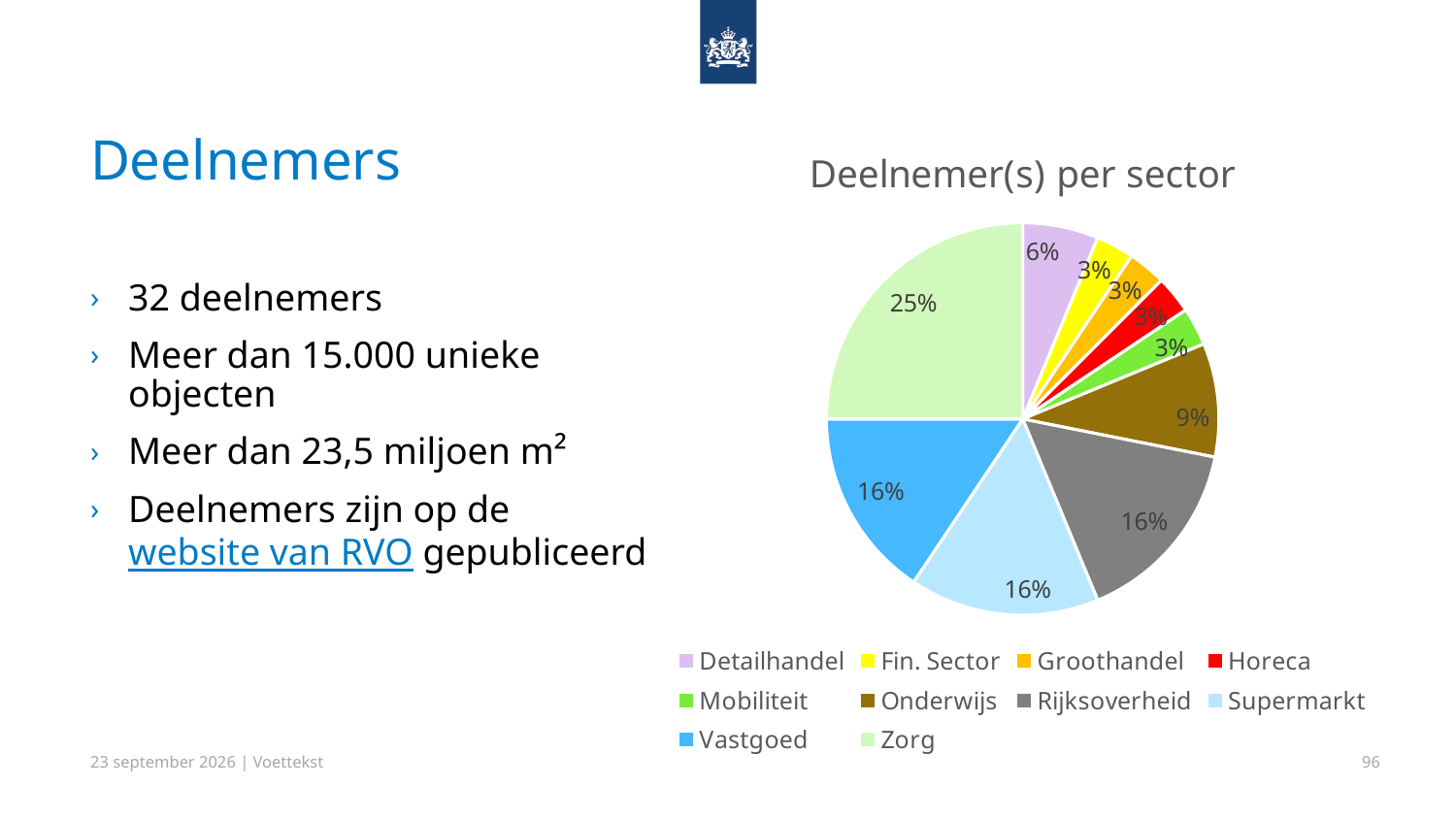
Which colour represents Zorg in the pie chart? light green What type of chart is shown on the slide? pie chart What percentage is shown for Onderwijs? 9% What is the title of the chart? Deelnemer(s) per sector What percentage is shown for Detailhandel? 6% Which has a larger share, Onderwijs or Detailhandel? Onderwijs What is the difference in percentage points between Zorg and Rijksoverheid? 9 How many sectors does the legend of the pie chart list? 10 What share of the pie does Zorg have? 25% Which sector has the largest share of the pie? Zorg What percentage is shown for Horeca? 3% What percentage is shown for Vastgoed? 16%